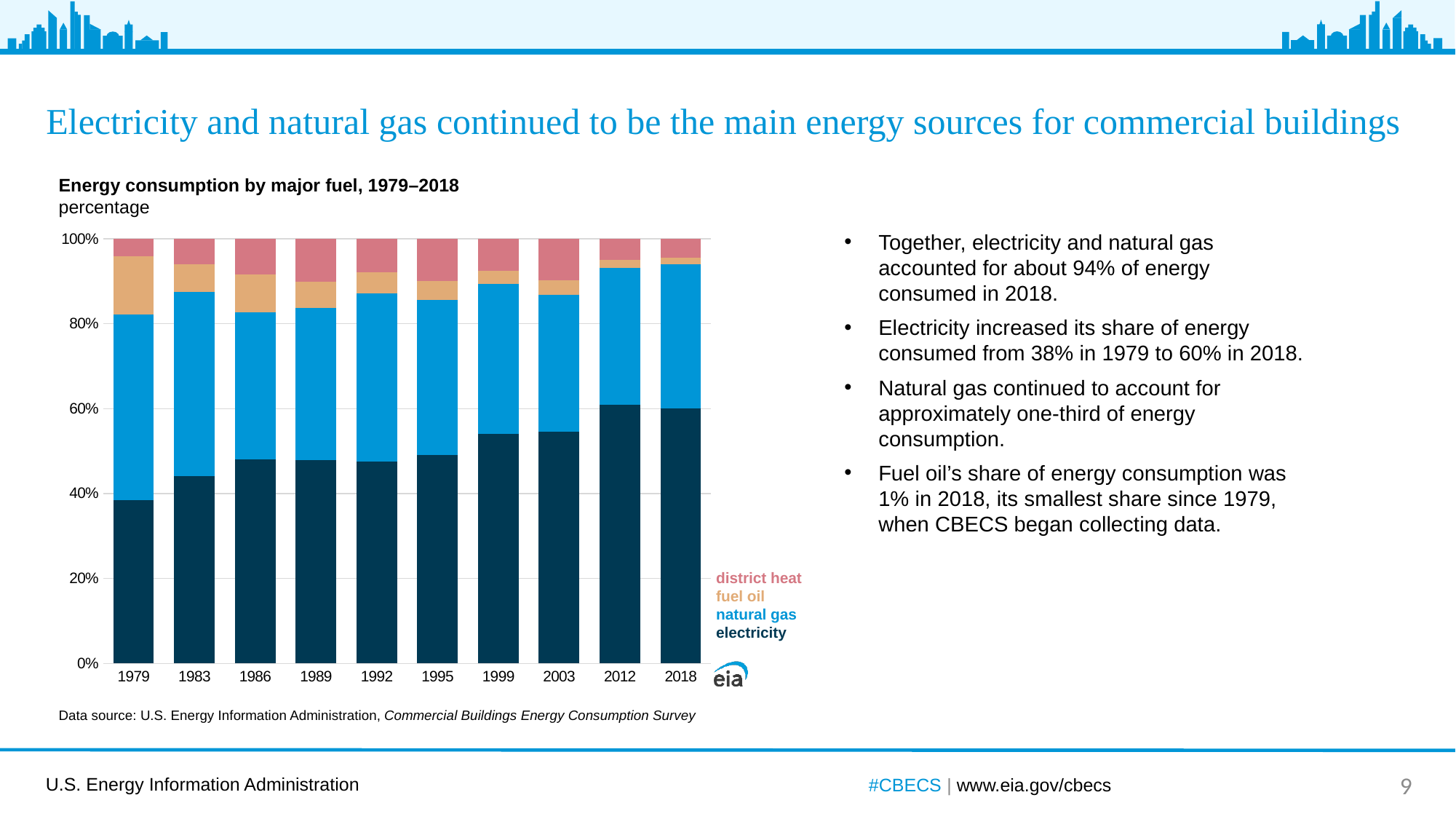
How many years (bars) are shown on the x axis of the chart? 10 In which year is the electricity share of energy consumption the lowest? 1979 Which year has the larger electricity share, 1979 or 2018? 2018 What kind of chart is shown on the slide? stacked bar chart Does the electricity share of energy consumption generally rise or fall from 1979 to 2018? rise Which fuel is shown by the dark navy segment at the bottom of each bar? electricity What is the title of the chart? Energy consumption by major fuel, 1979–2018 Is the electricity share in 1979 greater or less than 40%? less In which year is the fuel oil share of energy consumption the largest? 1979 Is the electricity share in 1999 greater or less than 50%? greater Is the electricity share in 1983 greater or less than 40%? greater How many fuel categories does the chart's legend list? 4